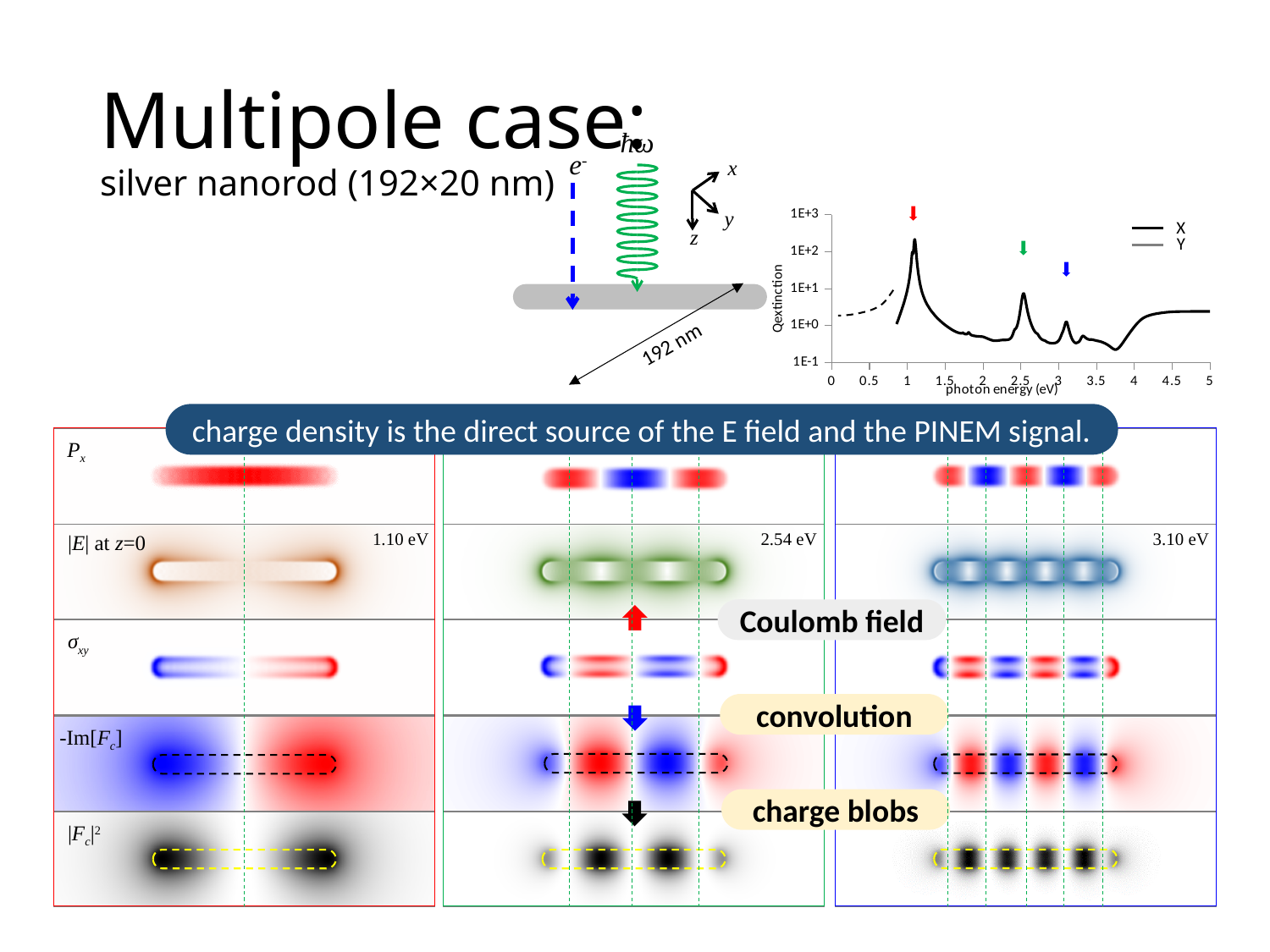
What are the two legend entries in the Qextinction chart? X and Y In the Qextinction chart, is the value of the X curve at 5 eV greater or less than 1E+0? greater In the Qextinction chart, is the value of the X curve at 5 eV greater or less than 1E+1? less In the Qextinction chart, is the peak near 3 eV higher or lower than the peak near 2.5 eV? lower In the Qextinction chart, is the peak near 2.5 eV higher or lower than the peak near 1 eV? lower What is the x-axis label of the Qextinction chart? photon energy (eV) In the Qextinction chart, is the highest peak of the X curve located near 1 eV or near 2.5 eV? near 1 eV In the Qextinction chart, is the highest peak of the X curve (near 1 eV) greater or less than 1E+2? greater How many series does the legend of the Qextinction chart list? 2 What kind of chart is the Qextinction versus photon energy plot? line chart